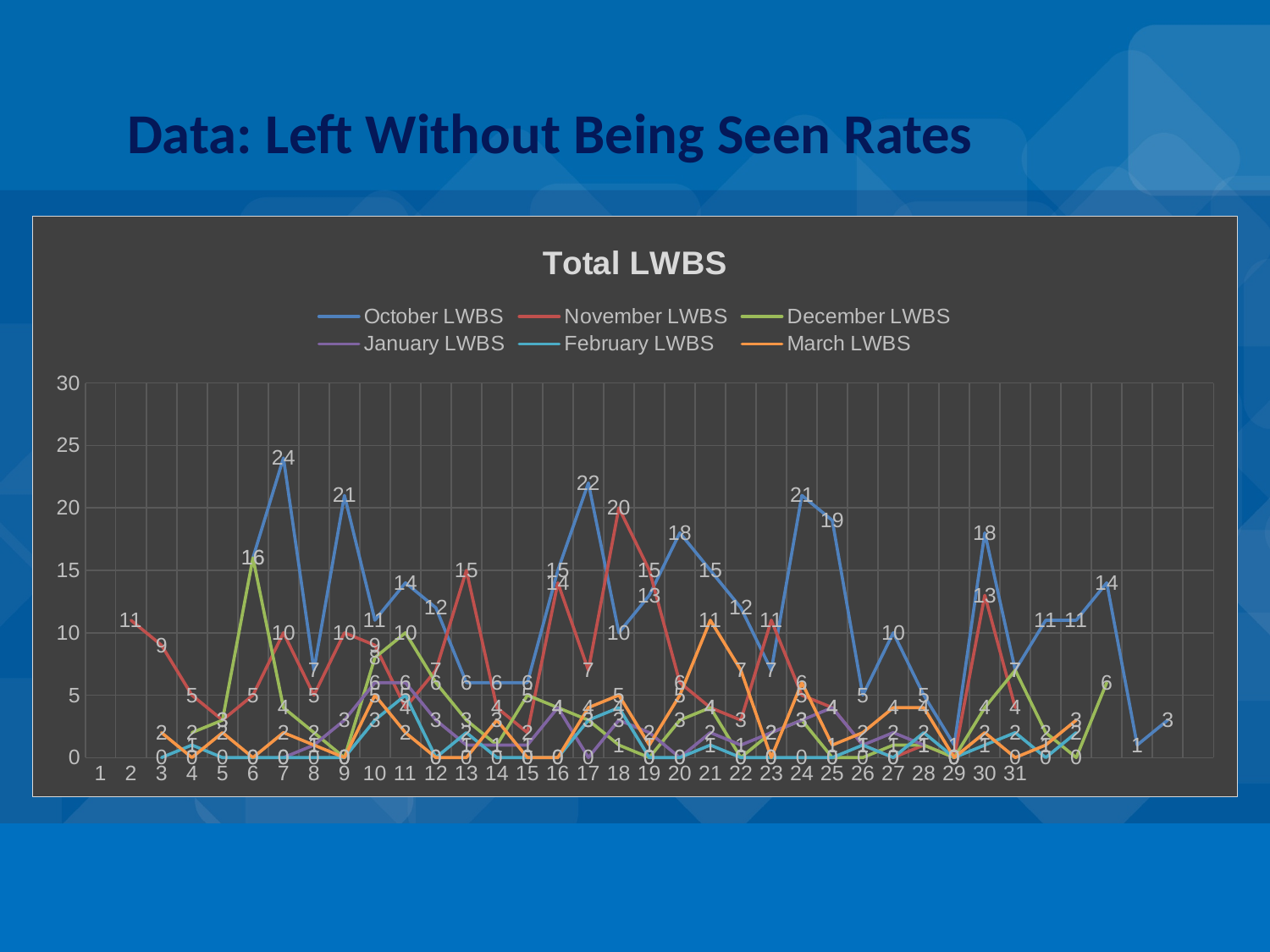
What is the October LWBS value on day 7? 24 On which day does the November LWBS series reach its highest value? 18 What is the title of the chart? Total LWBS Is the October LWBS value on day 7 greater or less than 20? greater On which day does the October LWBS series reach its highest value? 7 What is the November LWBS value on day 18? 20 Which is larger: the October LWBS value on day 7 or the November LWBS value on day 18? October LWBS on day 7 What is the December LWBS value on day 6? 16 What is the difference between the October LWBS value on day 7 and the November LWBS value on day 18? 4 What kind of chart is shown on the slide? line chart How many series does the legend of the Total LWBS chart list? 6